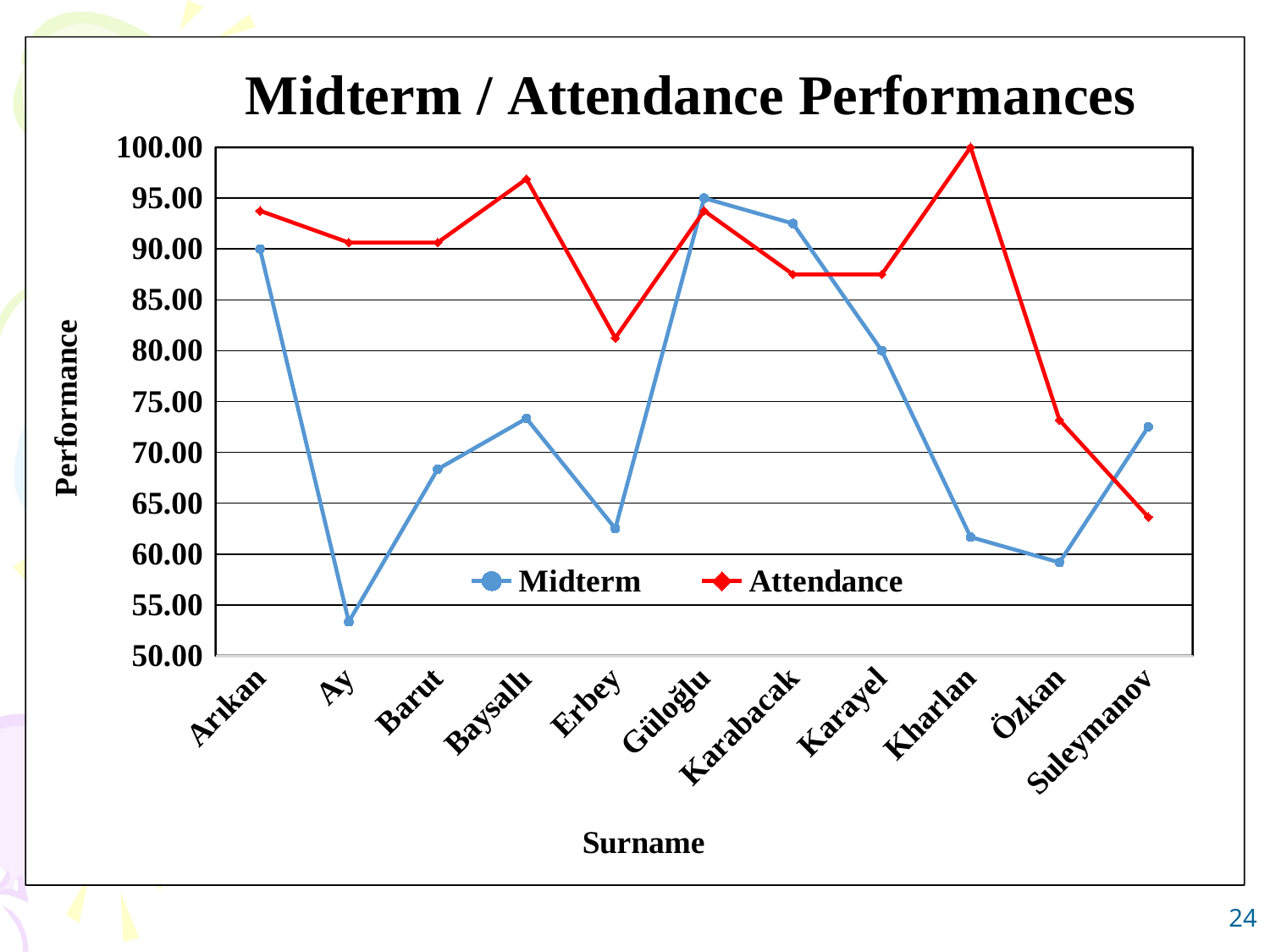
Which surname has the highest Attendance value? Kharlan How many surnames are plotted along the x axis? 11 For Arıkan, which is larger, the Midterm value or the Attendance value? Attendance Which surname has the lowest Midterm value? Ay Is the Midterm value for Ay greater or less than 55.00? less Which surname has the lowest Attendance value? Suleymanov What kind of chart is shown on the slide? line chart Is the Attendance value for Baysallı greater or less than 95.00? greater How many series does the legend list? 2 For Suleymanov, which is larger, the Midterm value or the Attendance value? Midterm What is the title of the chart? Midterm / Attendance Performances Which surname has the highest Midterm value? Güloğlu